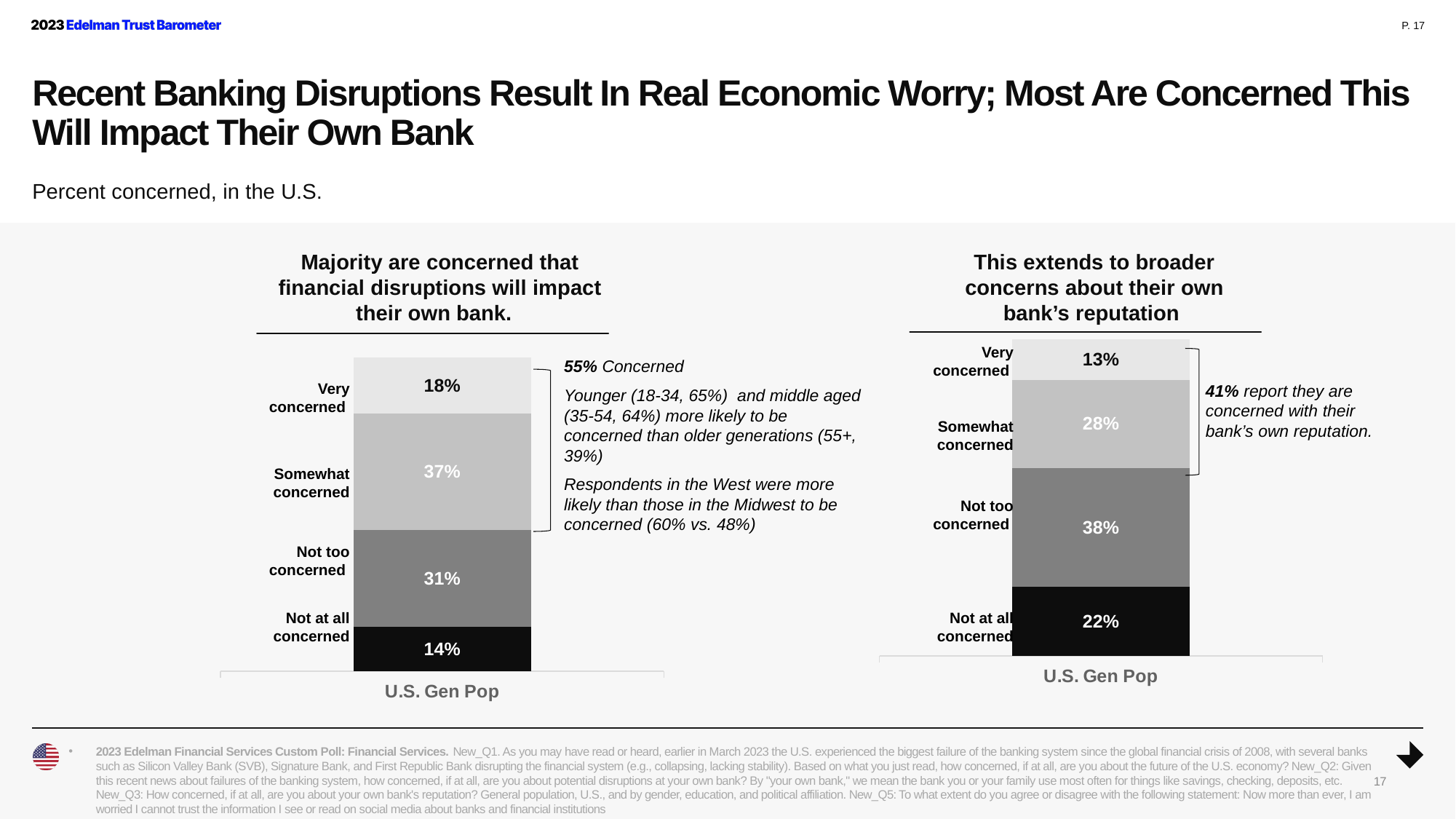
In the right chart about their own bank's reputation, what is the combined percentage of 'Very concerned' and 'Somewhat concerned'? 41% In the left chart about financial disruptions impacting their own bank, which response category has the highest percentage? Somewhat concerned In the left chart about financial disruptions impacting their own bank, what percentage is 'Not at all concerned'? 14% In the right chart about their own bank's reputation, what percentage is 'Very concerned'? 13% What type of chart is used on the right to show concerns about their own bank's reputation? Stacked bar chart In the right chart about their own bank's reputation, which response category has the lowest percentage? Very concerned In the left chart about financial disruptions impacting their own bank, what percentage is 'Somewhat concerned'? 37% Which is larger: 'Not at all concerned' in the left chart or 'Not at all concerned' in the right chart? Right chart (22%) How many response categories are shown in the left chart about financial disruptions impacting their own bank? 4 What is the x-axis category label under both charts? U.S. Gen Pop In the right chart about their own bank's reputation, what percentage is 'Not too concerned'? 38% In the left chart about financial disruptions impacting their own bank, what is the difference between 'Somewhat concerned' and 'Not too concerned'? 6%